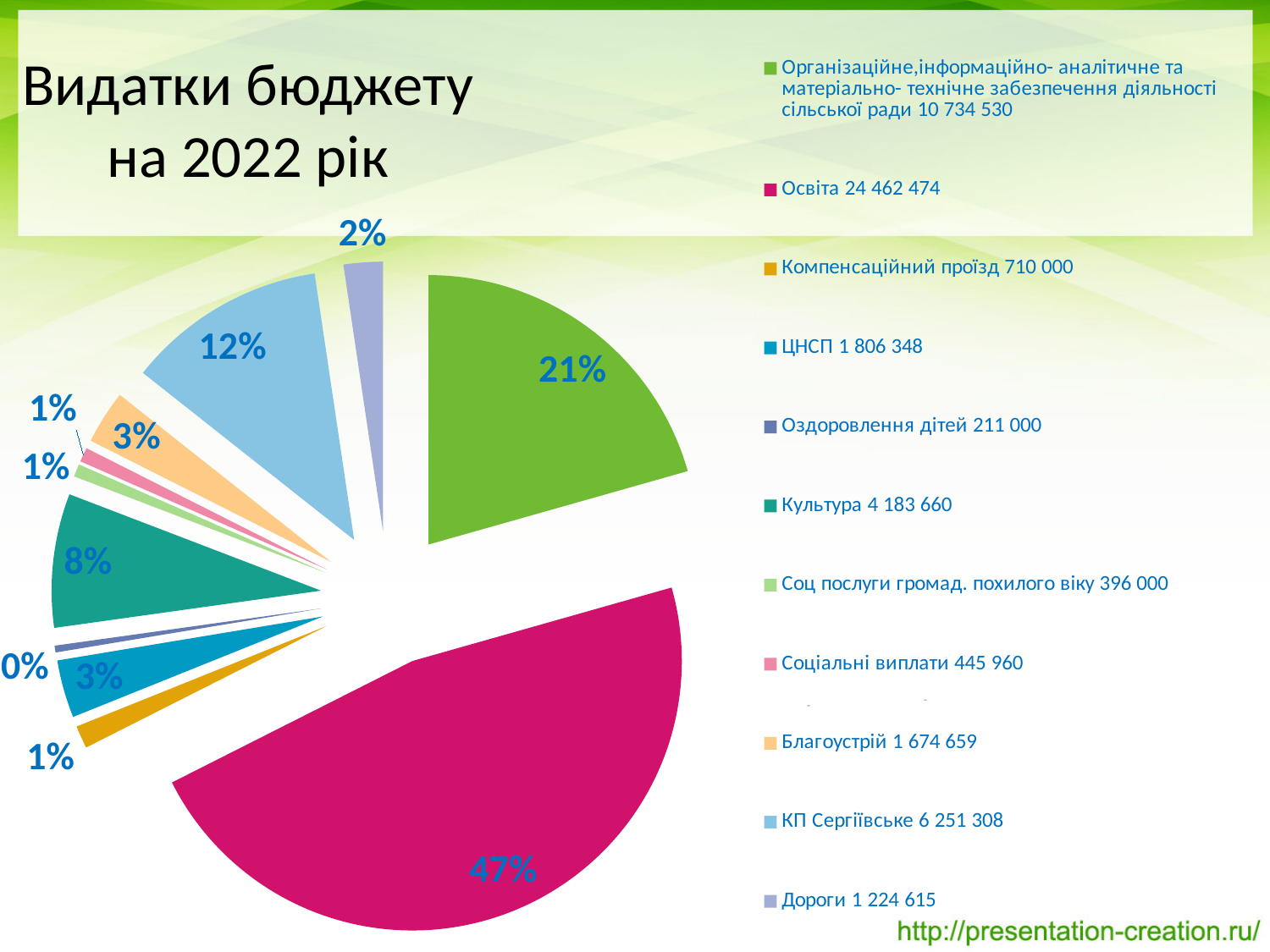
What share of the pie does Культура take? 8% What share of the pie does КП Сергіївське take? 12% What kind of chart is shown on the slide? pie chart Which slice is larger, Культура or ЦНСП? Культура How many categories does the legend of the pie chart list? 11 What value is shown in the legend for Культура? 4 183 660 Which category has the smallest slice of the pie? Оздоровлення дітей What is the difference in percentage points between the Освіта slice and the Організаційне, інформаційно-аналітичне та матеріально-технічне забезпечення діяльності сільської ради slice? 26% Which category has the largest slice of the pie? Освіта What share of the pie does Освіта take? 47% What is the title of the chart on the slide? Видатки бюджету на 2022 рік What value is shown in the legend for Дороги? 1 224 615